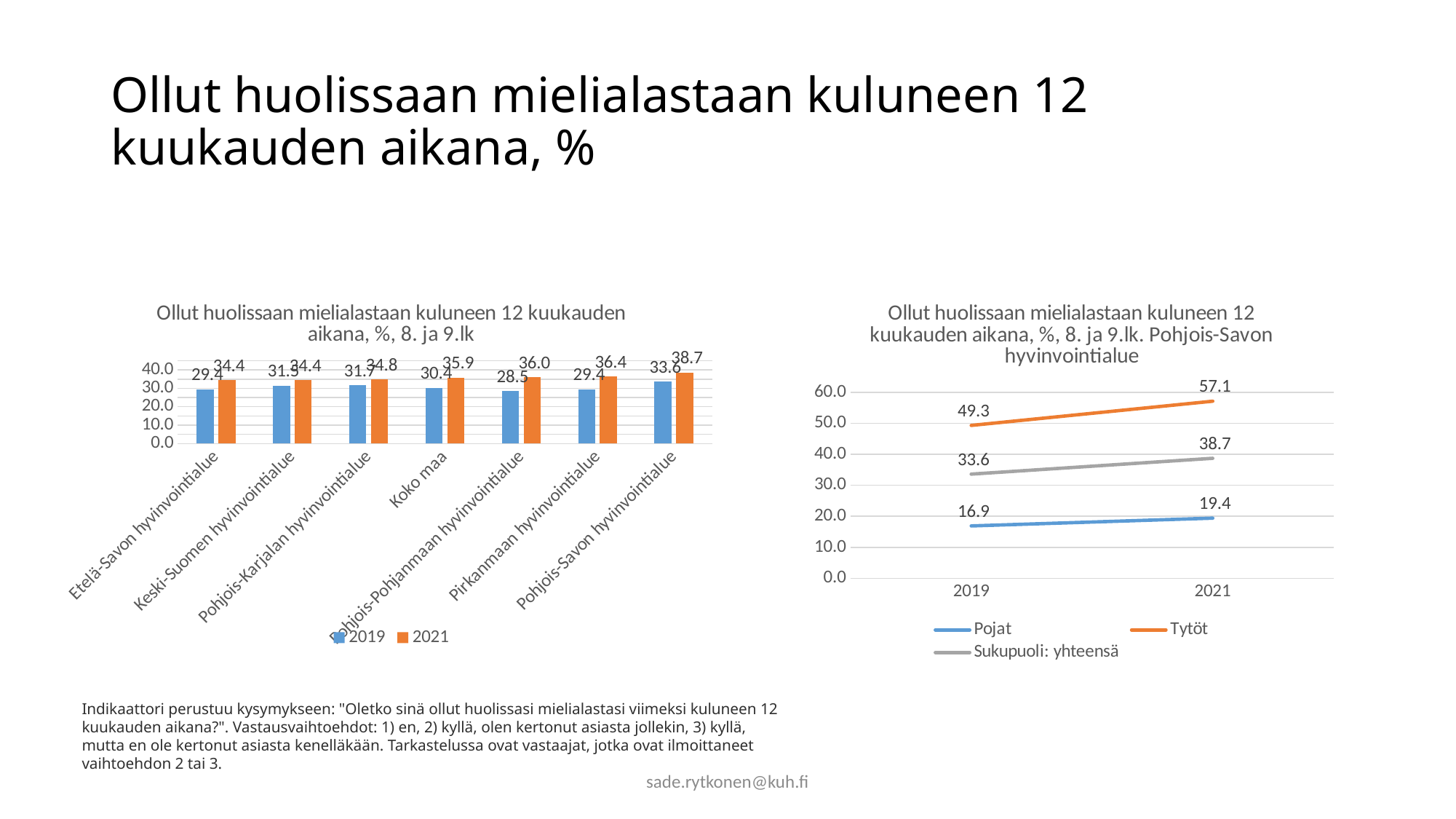
In the right line chart, how many series does the legend list? 3 In the left bar chart, how many categories are shown on the x axis? 7 In the right line chart, does the Pojat line rise or fall from 2019 to 2021? rise In the left bar chart, which category has the lowest 2019 value? Pohjois-Pohjanmaan hyvinvointialue What kind of chart is the chart on the left of the slide? bar chart In the right line chart, what is the value for Tytöt in 2021? 57.1 In the left bar chart, which category has the highest 2021 value? Pohjois-Savon hyvinvointialue In the left bar chart, what is the 2021 value for Pohjois-Savon hyvinvointialue? 38.7 In the left bar chart, what is the 2019 value for Koko maa? 30.4 In the left bar chart, what is the difference between the 2021 and 2019 values for Pirkanmaan hyvinvointialue? 7.0 In the right line chart, what is the difference between the Tytöt and Pojat values in 2019? 32.4 In the left bar chart, how many series does the legend list? 2